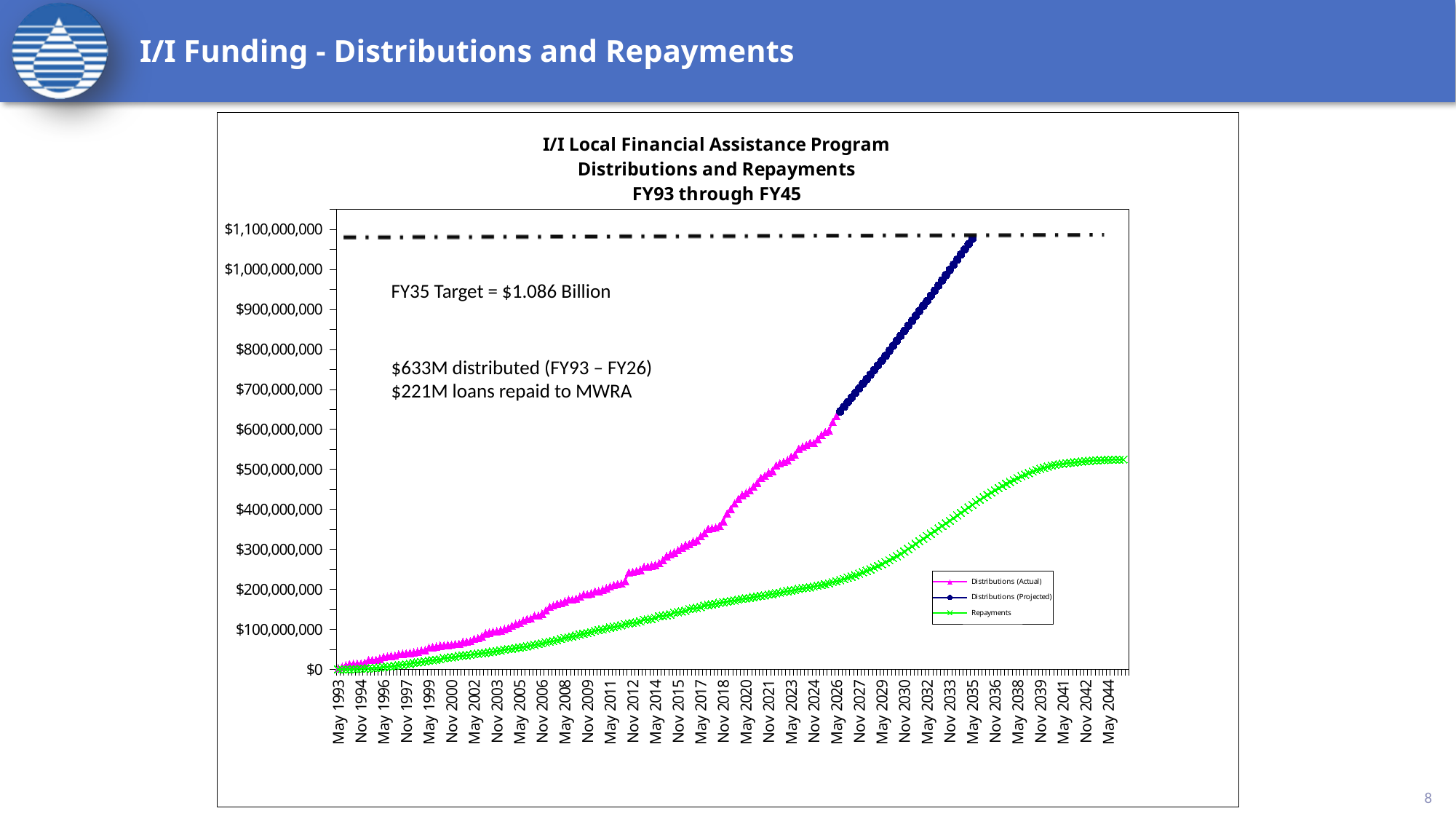
Do the Repayments values rise or fall from May 1993 to May 2044? rise According to the chart annotation, how much was distributed from FY93 through FY26? $633M How many series does the chart legend list? 3 Is the value of Distributions (Projected) at May 2035 greater or less than $1,000,000,000? greater What kind of chart is shown on the slide? line chart Is the value of Distributions (Actual) at May 2026 greater or less than $700,000,000? less Is the value of Distributions (Actual) at May 2012 greater or less than $300,000,000? less At May 2026, which series has the higher value, Distributions (Actual) or Repayments? Distributions (Actual) Do the Distributions (Actual) values rise or fall from May 1993 to May 2026? rise What is the FY35 target stated on the chart? $1.086 Billion